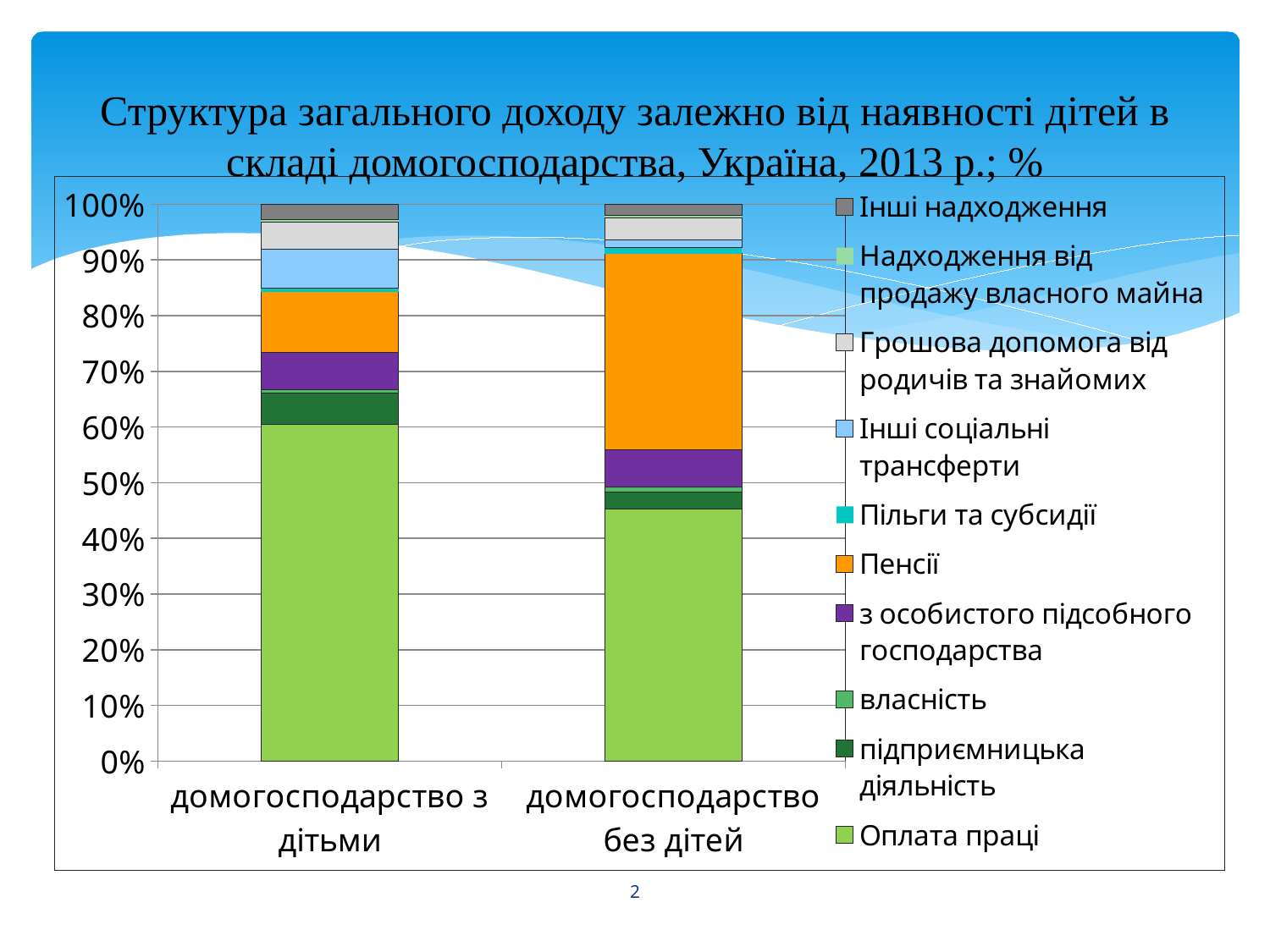
How many categories are shown on the x axis of the chart? 2 Is the share of Оплата праці for домогосподарство без дітей greater or less than 50%? less Is the share of Оплата праці for домогосподарство з дітьми greater or less than 50%? greater Is the share of Пенсії for домогосподарство без дітей greater or less than 30%? greater What colour represents the Пенсії series in the chart? orange What kind of chart is shown on the slide? stacked bar chart Which category has the larger share for Оплата праці: домогосподарство з дітьми or домогосподарство без дітей? домогосподарство з дітьми What is the title of the chart? Структура загального доходу залежно від наявності дітей в складі домогосподарства, Україна, 2013 р.; % How many series does the legend list? 10 What is the total of the stacked bar for домогосподарство з дітьми? 100% Which category has the larger share for Пенсії: домогосподарство з дітьми or домогосподарство без дітей? домогосподарство без дітей